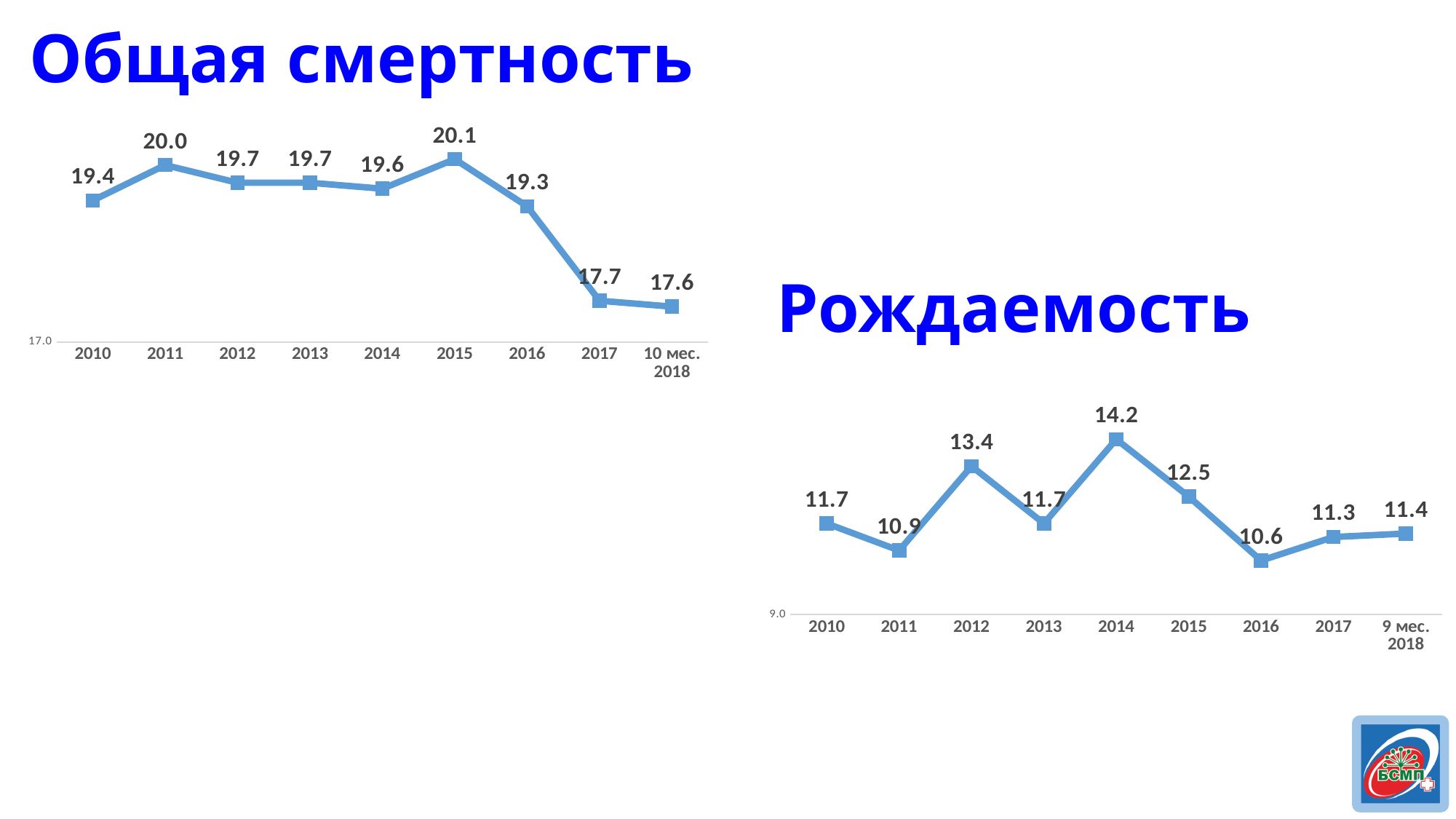
In the "Рождаемость" chart, what is the difference between the 2014 and 2016 values? 3.6 In the "Общая смертность" chart, how many data points are plotted? 9 In the "Общая смертность" chart, what is the value for 10 мес. 2018? 17.6 In the "Общая смертность" chart, do the values rise or fall from 2015 to 2017? Fall In the "Рождаемость" chart, what is the value for 2014? 14.2 What kind of chart is the "Рождаемость" chart? Line chart In the "Общая смертность" chart, which point has the lowest value? 10 мес. 2018 In the "Рождаемость" chart, which year has the lowest value? 2016 In the "Общая смертность" chart, which year has the highest value? 2015 In the "Общая смертность" chart, what is the difference between the 2016 and 2017 values? 1.6 In the "Общая смертность" chart, what is the value for 2015? 20.1 In the "Рождаемость" chart, which is larger, the value for 2012 or the value for 2015? 2012